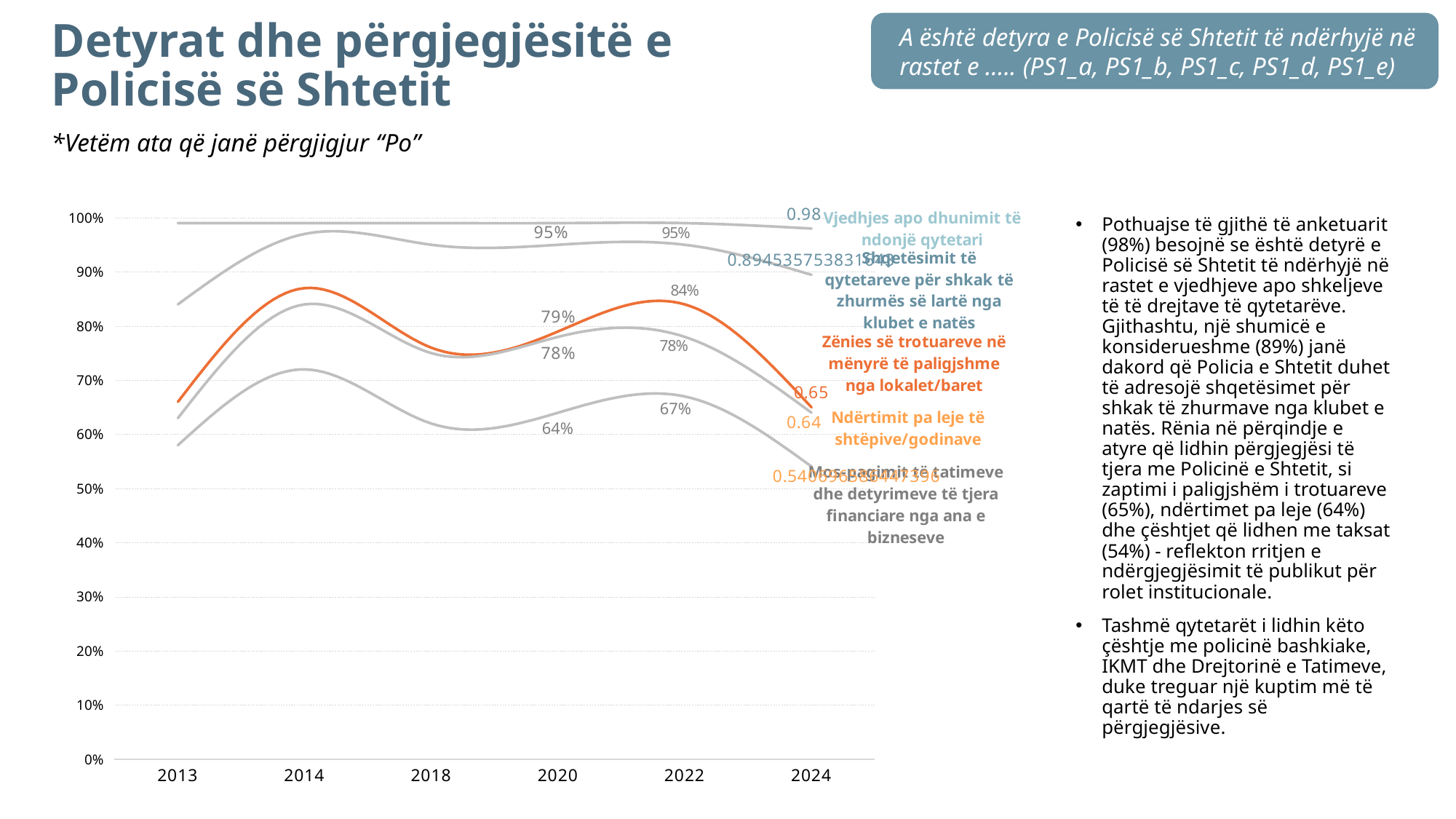
What is the value for 'Zënies së trotuareve në mënyrë të paligjshme nga lokalet/baret' in 2022? 84% In 2022, which is larger: 'Zënies së trotuareve në mënyrë të paligjshme nga lokalet/baret' or 'Ndërtimit pa leje të shtëpive/godinave'? Zënies së trotuareve në mënyrë të paligjshme nga lokalet/baret Which series has the lowest value in 2024? Mos-pagimit të tatimeve dhe detyrimeve të tjera financiare nga ana e bizneseve What is the value for 'Vjedhjes apo dhunimit të ndonjë qytetari' in 2024? 0.98 What kind of chart is shown on the slide? line chart Is the value for 'Vjedhjes apo dhunimit të ndonjë qytetari' in 2013 greater or less than 90%? greater How many lines (series) are plotted on the chart? 5 Does the line for 'Zënies së trotuareve në mënyrë të paligjshme nga lokalet/baret' rise or fall between 2022 and 2024? fall By how many percentage points did 'Zënies së trotuareve në mënyrë të paligjshme nga lokalet/baret' change from 2020 to 2022? 5 percentage points What is the value for 'Ndërtimit pa leje të shtëpive/godinave' in 2020? 78% What is the value for 'Mos-pagimit të tatimeve dhe detyrimeve të tjera financiare nga ana e bizneseve' in 2022? 67% How many years are shown on the x axis of the chart? 6